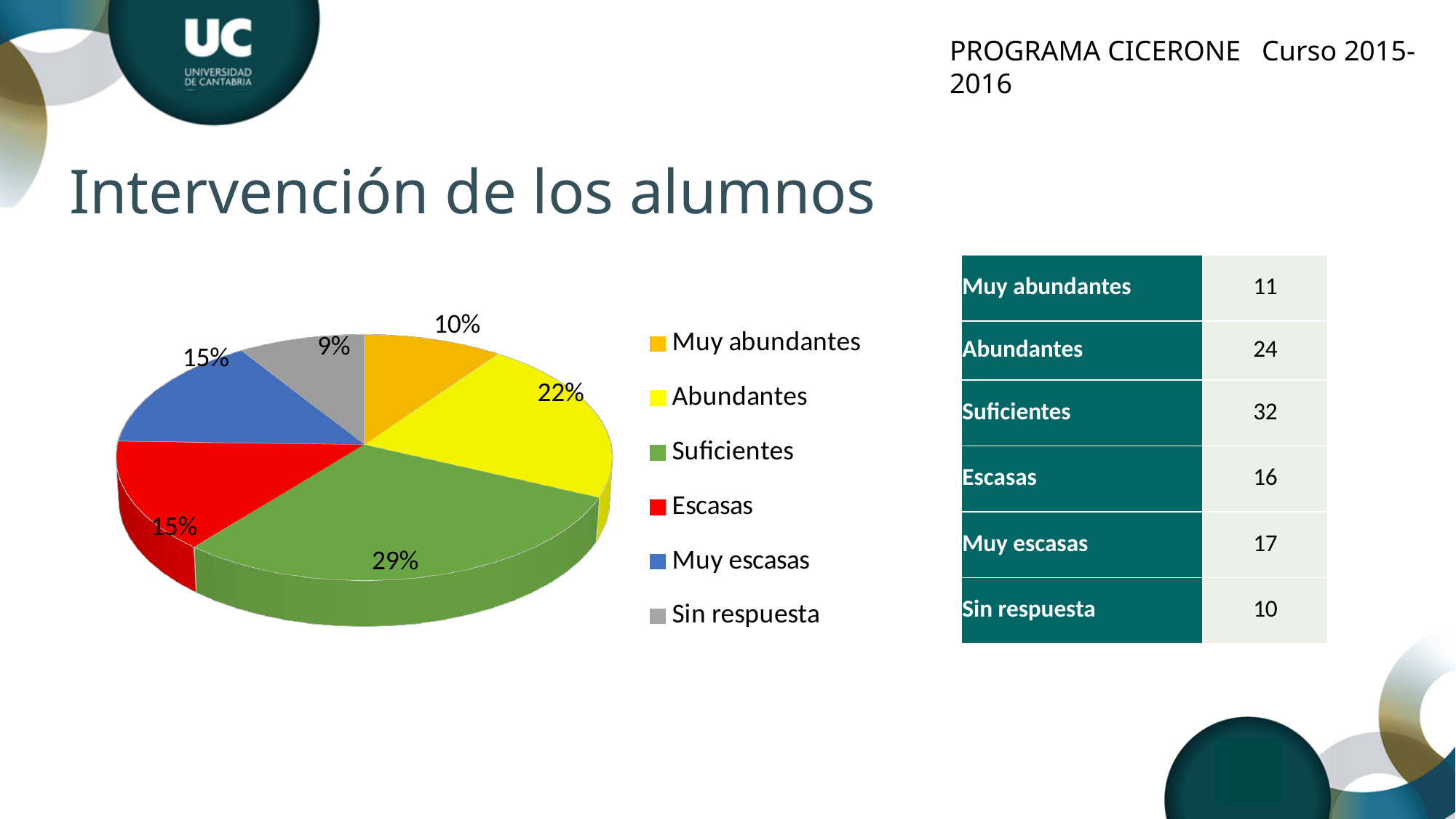
What type of chart is shown on the slide? pie chart Which category has the largest slice in the pie chart? Suficientes Which category has the smallest slice in the pie chart? Sin respuesta What percentage of the pie chart corresponds to Sin respuesta? 9% What percentage of the pie chart corresponds to Abundantes? 22% How many categories does the pie chart show? 6 Which slice is larger, Abundantes or Escasas? Abundantes What colour is the Suficientes slice in the pie chart? green What percentage of the pie chart corresponds to Muy abundantes? 10% What percentage of the pie chart corresponds to Suficientes? 29% What percentage of the pie chart corresponds to Muy escasas? 15% What is the difference in percentage points between the Suficientes slice and the Abundantes slice? 7